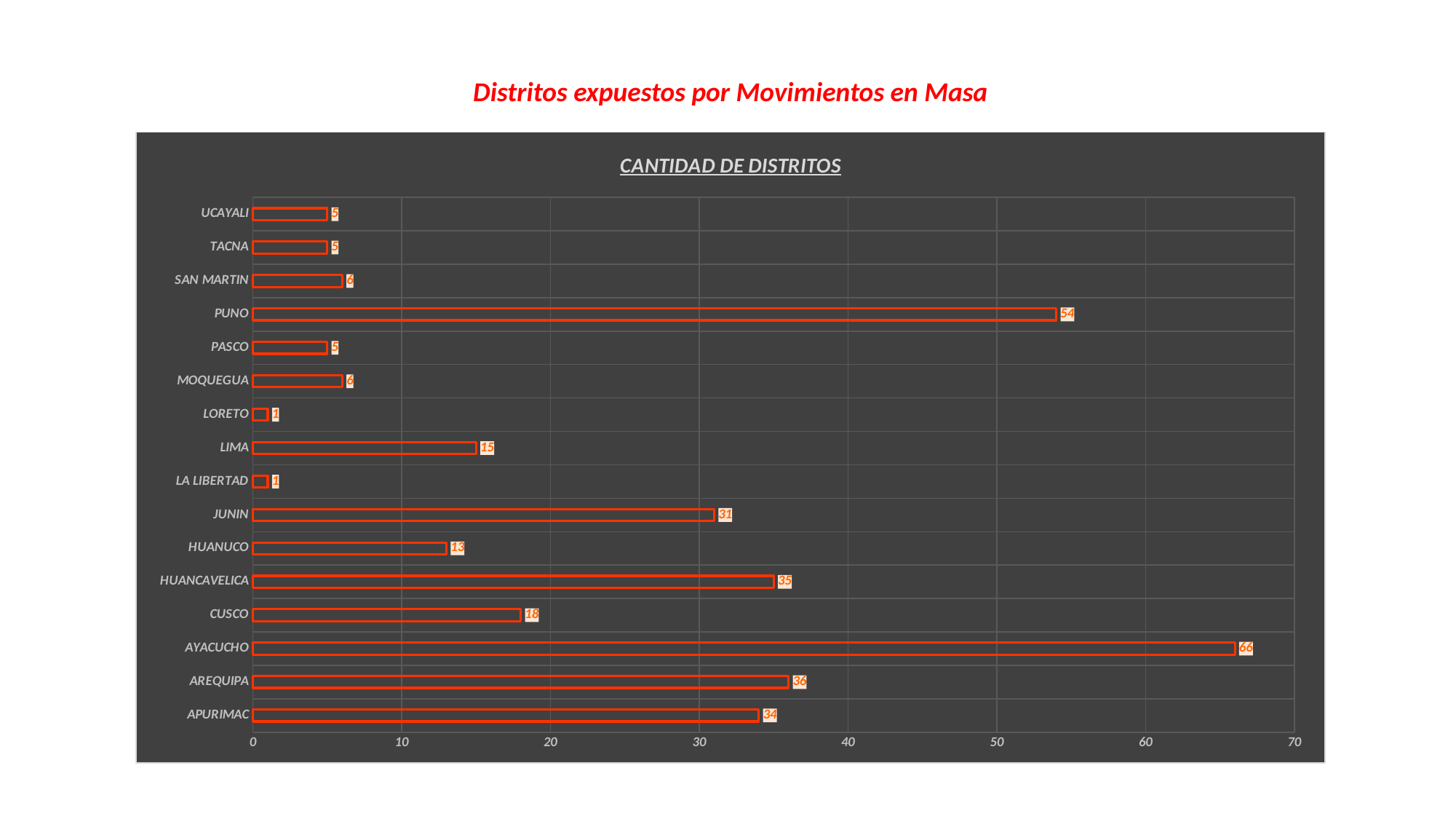
What is the title of the chart? CANTIDAD DE DISTRITOS What kind of chart is shown on the slide? bar chart What is the difference between the values for AYACUCHO and PUNO? 12 Which is larger, the value for AREQUIPA or the value for APURIMAC? AREQUIPA What is the value for HUANCAVELICA? 35 How many categories are shown on the chart? 16 What is the value for PUNO? 54 What is the difference between the values for CUSCO and HUANUCO? 5 What is the value for LIMA? 15 Which category has the highest value? AYACUCHO Is the value for JUNIN greater or less than 30? greater What is the value for AYACUCHO? 66